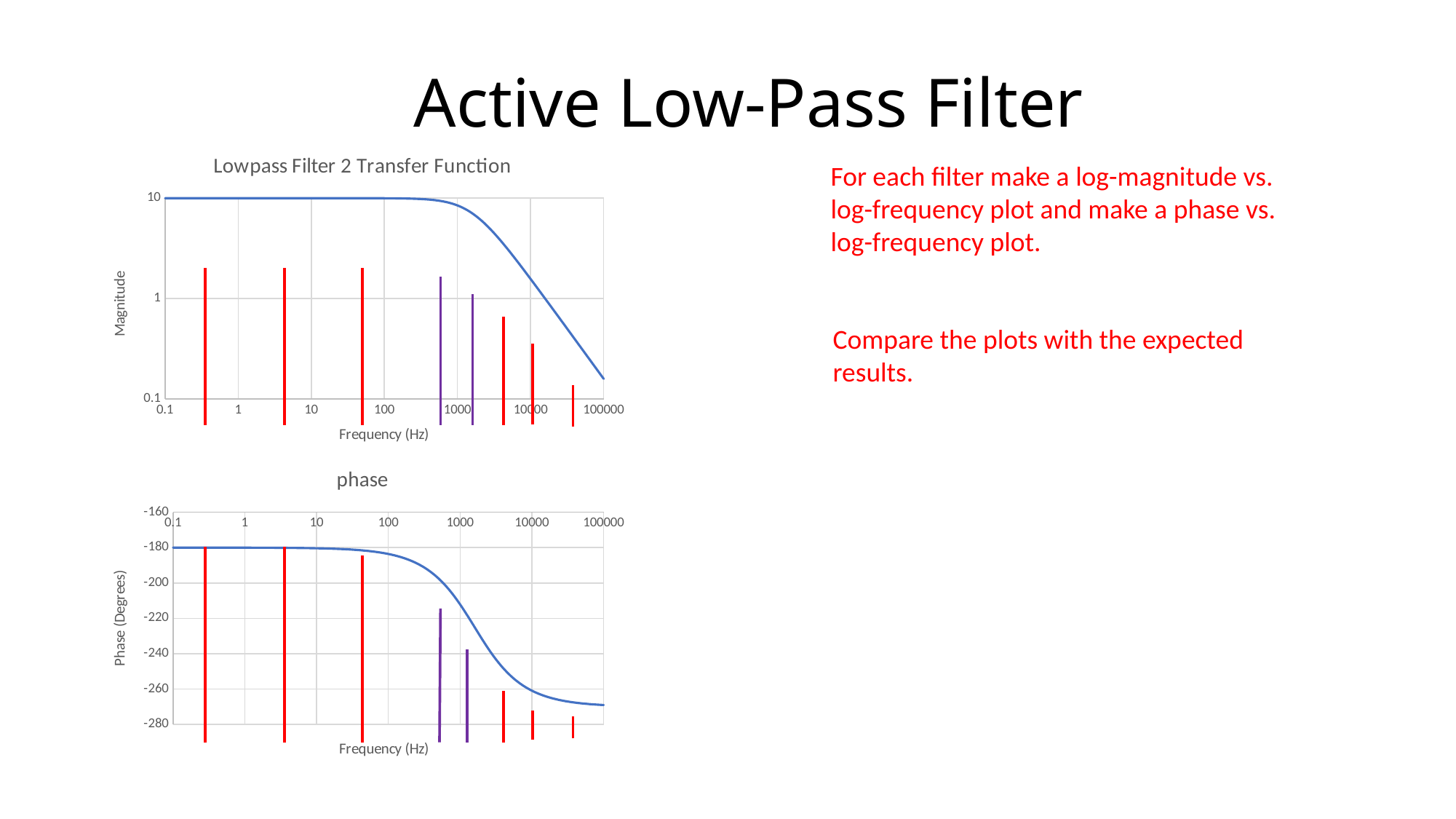
In the phase chart, is the phase at 100000 Hz greater or less than -260? less In the Lowpass Filter 2 Transfer Function chart, what kind of chart is the blue curve? line chart What is the x-axis label of the phase chart? Frequency (Hz) In the phase chart, is the phase at 10000 Hz greater or less than -240? less In the phase chart, is the phase at 1 Hz greater or less than -200? greater In the phase chart, does the phase increase or decrease as frequency increases from 100 Hz to 10000 Hz? decrease What is the title of the bottom chart on the slide? phase In the Lowpass Filter 2 Transfer Function chart, does the magnitude rise or fall as frequency increases past 1000 Hz? fall In the Lowpass Filter 2 Transfer Function chart, how many vertical bars are drawn on the plot? 8 What is the title of the top chart on the slide? Lowpass Filter 2 Transfer Function